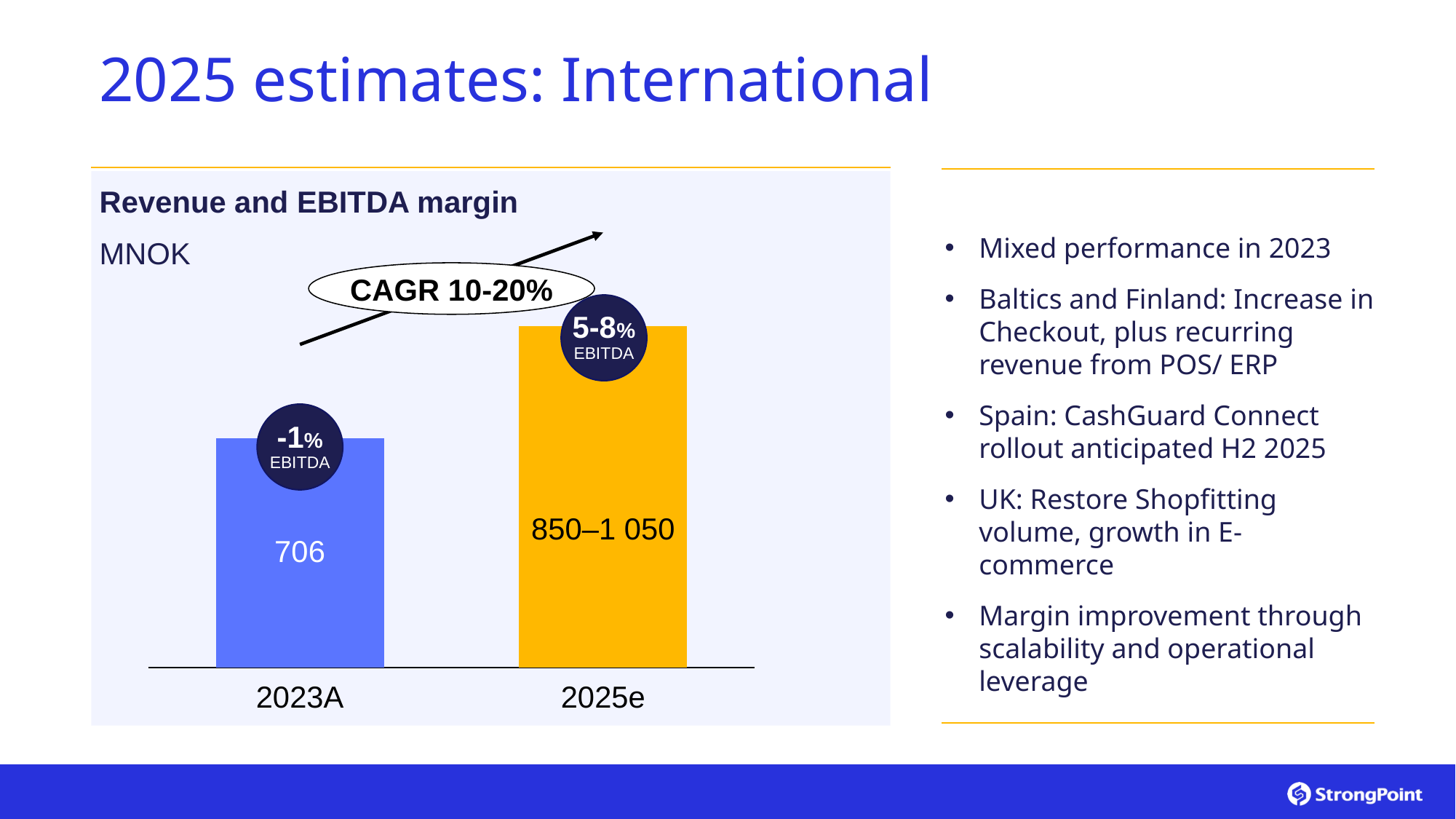
What is the revenue value shown for 2023A? 706 What EBITDA margin is shown for 2025e? 5-8% What EBITDA margin is shown for 2023A? -1% What is the revenue estimate shown for 2025e? 850–1 050 Do the bar values rise or fall from 2023A to 2025e? Rise How many categories are shown on the x axis? 2 What kind of chart is shown on the slide? Bar chart Which category has the lowest revenue bar? 2023A What is the title of the chart? Revenue and EBITDA margin Which category has the taller bar, 2023A or 2025e? 2025e What CAGR range is shown on the chart? 10-20%